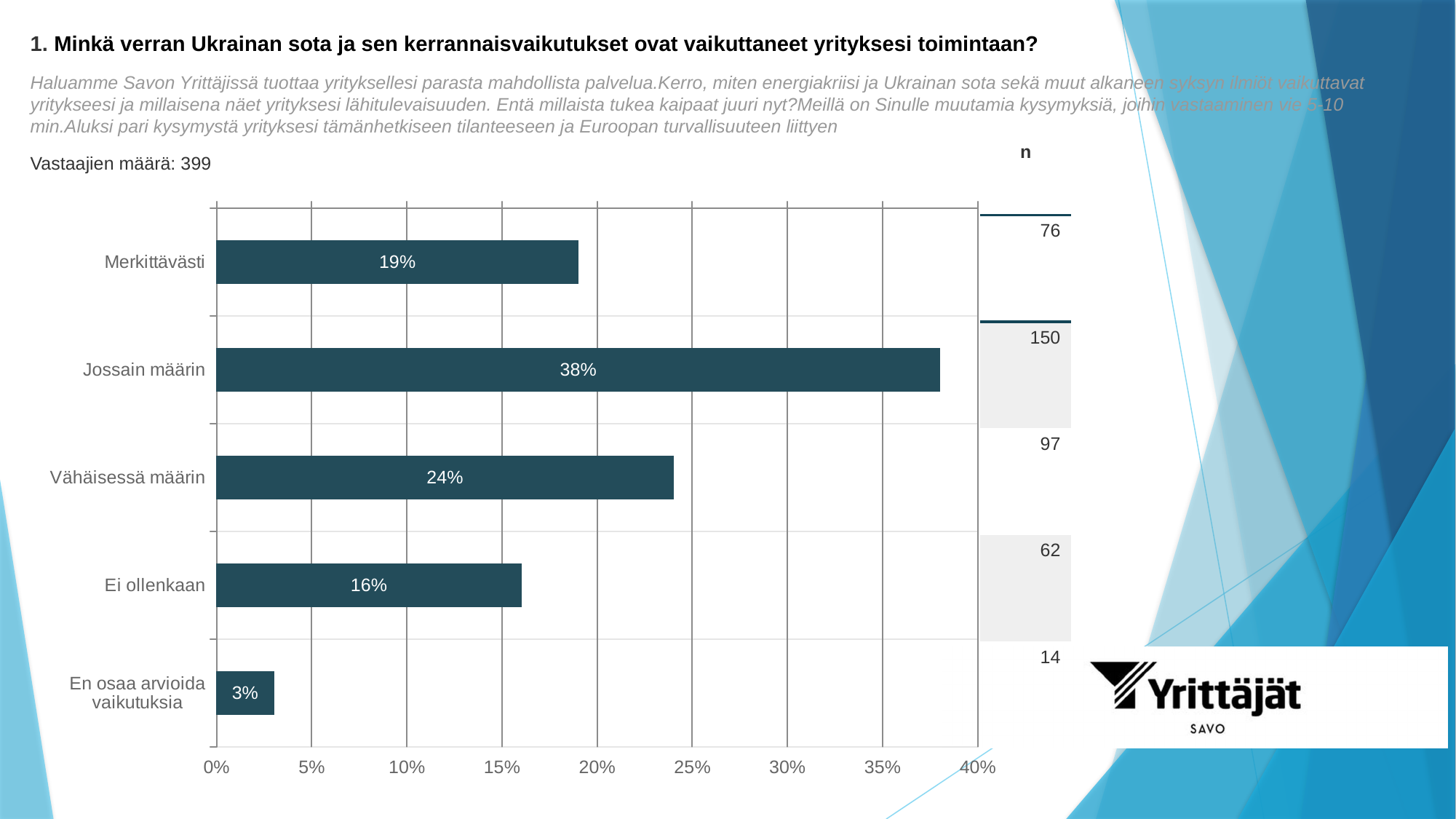
What is the n value shown for "Vähäisessä määrin"? 97 What percentage is shown for "Jossain määrin"? 38% Is the value for "Merkittävästi" greater or less than 20%? less How many categories are shown in the chart? 5 What is the difference in percentage points between "Jossain määrin" and "Merkittävästi"? 19 Which category has the highest percentage? Jossain määrin What kind of chart is shown on the slide? bar chart Which is larger, the percentage for "Vähäisessä määrin" or for "Ei ollenkaan"? Vähäisessä määrin What is the maximum value shown on the percentage axis? 40% What is the total number of respondents (Vastaajien määrä) stated on the slide? 399 What percentage is shown for "Ei ollenkaan"? 16% Which category has the lowest percentage? En osaa arvioida vaikutuksia